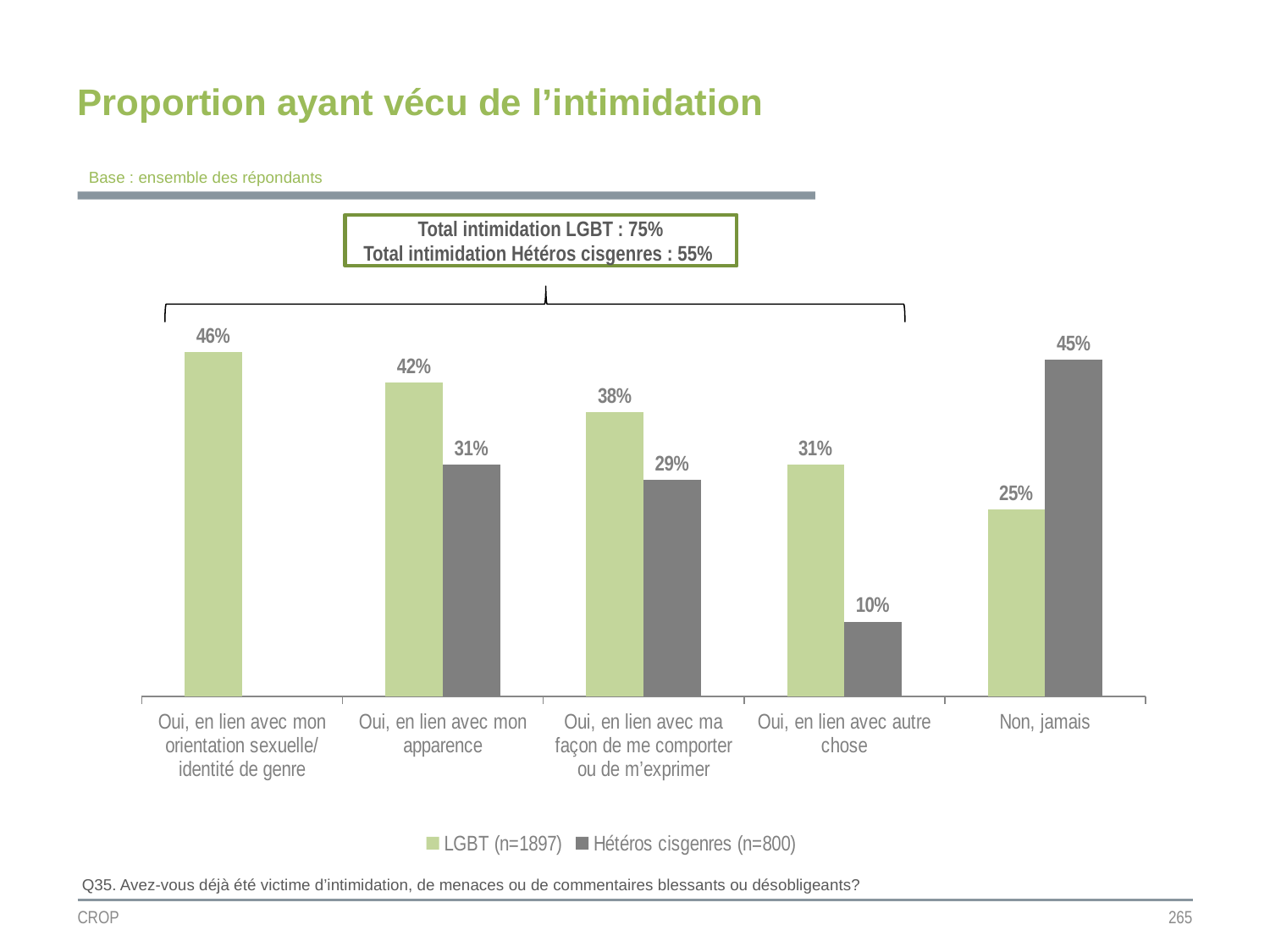
How many categories are shown on the x axis? 5 What is the difference between the LGBT and Hétéros cisgenres values for "Oui, en lien avec autre chose"? 21% How many series does the legend list? 2 Which is larger for "Oui, en lien avec ma façon de me comporter ou de m'exprimer": the LGBT value or the Hétéros cisgenres value? LGBT What is the difference between the Hétéros cisgenres and LGBT values for "Non, jamais"? 20% What is the total intimidation value for LGBT shown in the box above the chart? 75% Which category has the lowest Hétéros cisgenres value? Oui, en lien avec autre chose What is the Hétéros cisgenres value for "Oui, en lien avec autre chose"? 10% What is the Hétéros cisgenres value for "Non, jamais"? 45% Which category has the highest LGBT value? Oui, en lien avec mon orientation sexuelle/ identité de genre What is the LGBT value for "Oui, en lien avec mon apparence"? 42% What kind of chart is shown on the slide? Bar chart